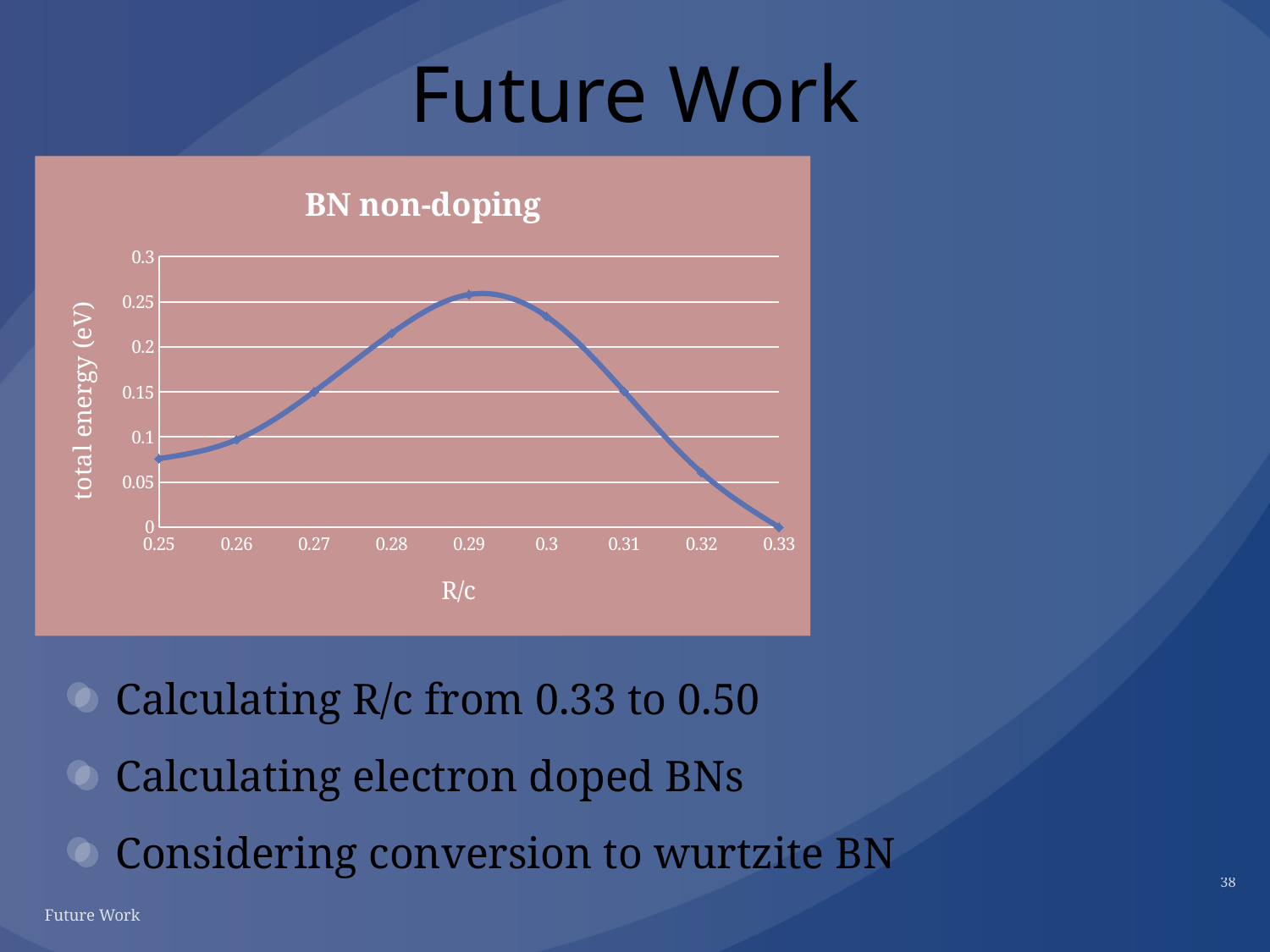
How does the total energy change as R/c increases from 0.25 to 0.33? rises to a peak at 0.29, then falls Is the total energy at R/c = 0.33 greater or less than 0.05? less What type of chart is shown on the slide? line chart What is the title of the chart? BN non-doping What is the label of the y axis? total energy (eV) Which has the higher total energy, R/c = 0.28 or R/c = 0.32? 0.28 Is the total energy at R/c = 0.25 greater or less than 0.1? less How many data points are plotted on the line? 9 At which R/c value is the total energy highest? 0.29 Is the total energy at R/c = 0.28 greater or less than 0.2? greater At which R/c value is the total energy lowest? 0.33